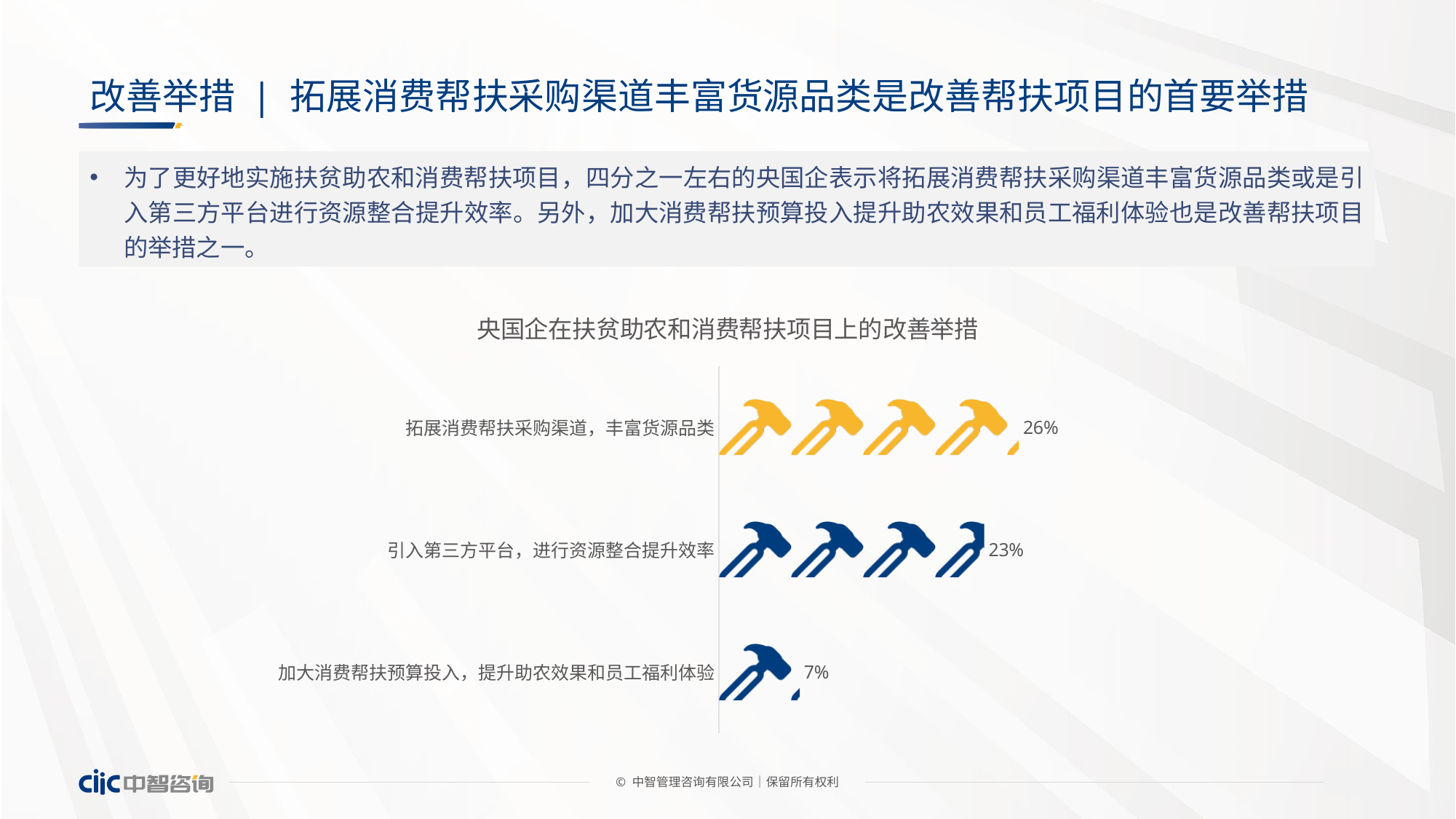
What is the value for 引入第三方平台，进行资源整合提升效率? 23% What is the value for 加大消费帮扶预算投入，提升助农效果和员工福利体验? 7% What is the difference between the values for 引入第三方平台，进行资源整合提升效率 and 加大消费帮扶预算投入，提升助农效果和员工福利体验? 16% What kind of chart is this? Bar chart (pictogram bar chart) What colour are the icons for the 拓展消费帮扶采购渠道，丰富货源品类 bar? Yellow What is the value for 拓展消费帮扶采购渠道，丰富货源品类? 26% How many categories does the chart show? 3 What is the difference between the values for 拓展消费帮扶采购渠道，丰富货源品类 and 引入第三方平台，进行资源整合提升效率? 3% Which is larger: the value for 引入第三方平台，进行资源整合提升效率 or the value for 加大消费帮扶预算投入，提升助农效果和员工福利体验? 引入第三方平台，进行资源整合提升效率 Which category has the highest value? 拓展消费帮扶采购渠道，丰富货源品类 What is the title of the chart? 央国企在扶贫助农和消费帮扶项目上的改善举措 Which category has the lowest value? 加大消费帮扶预算投入，提升助农效果和员工福利体验